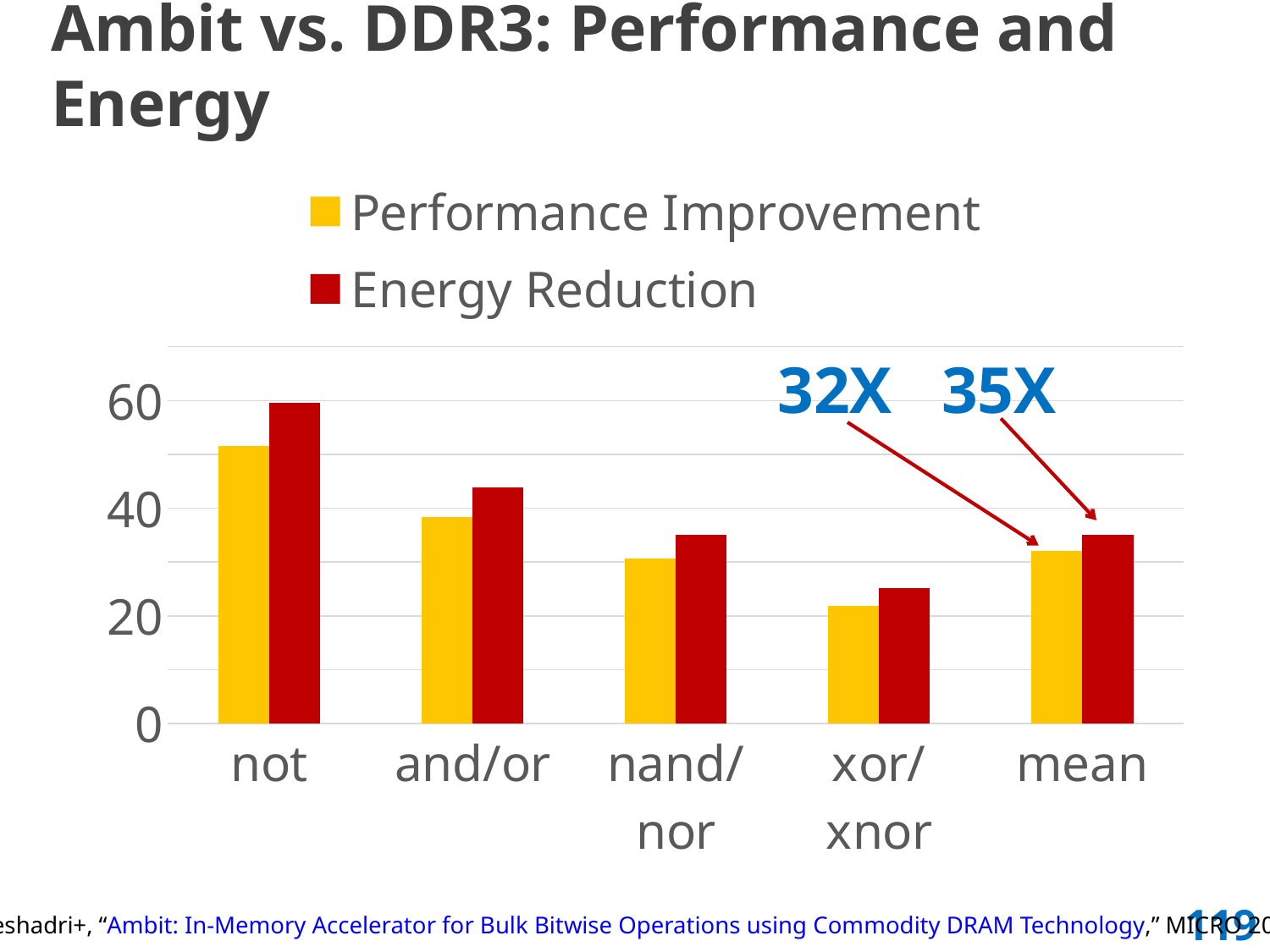
How many categories are shown on the x axis? 5 What is the mean Performance Improvement according to the annotation? 32X How many series does the legend list? 2 What colour are the Energy Reduction bars? red Which category has the highest Energy Reduction? not Do the Performance Improvement values rise or fall from not to xor/xnor? fall What kind of chart is shown on the slide? bar chart Is the Energy Reduction for not greater or less than 40? greater Which has a larger Energy Reduction, not or and/or? not Which category has the lowest Performance Improvement? xor/xnor What is the difference between the mean Energy Reduction and the mean Performance Improvement? 3X What is the mean Energy Reduction according to the annotation? 35X